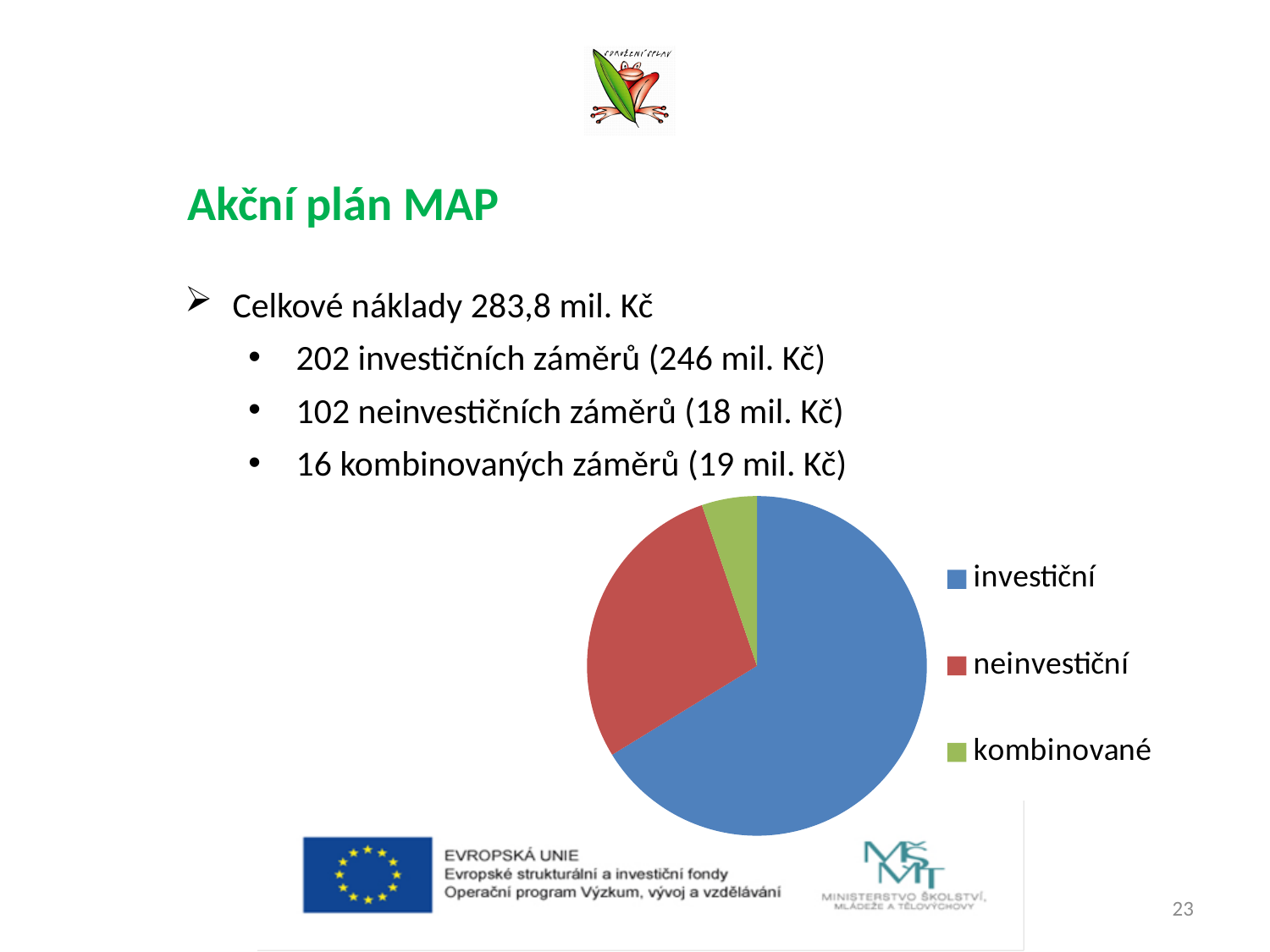
What kind of chart is shown on the slide? pie chart How many slices does the pie chart have? 3 Which slice is larger in the pie chart, neinvestiční or kombinované? neinvestiční Which category has the largest slice in the pie chart? investiční Which slice is larger in the pie chart, investiční or neinvestiční? investiční Which category has the smallest slice in the pie chart? kombinované How many entries does the legend of the pie chart list? 3 Which category is shown in green in the pie chart? kombinované Does the investiční slice take up more or less than half of the pie chart? more What colour is the investiční slice in the pie chart? blue